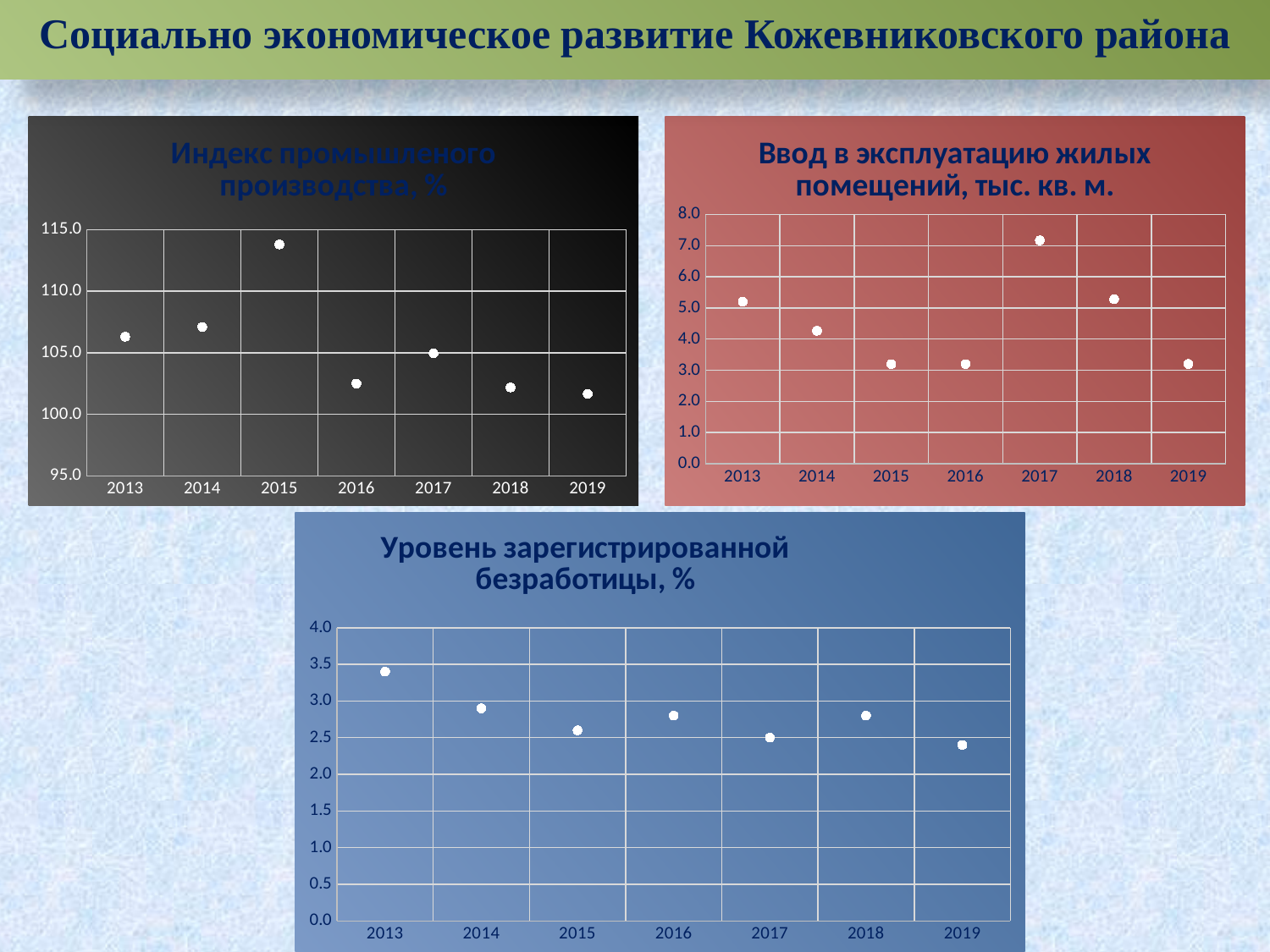
In the top-left chart, which year has the highest value? 2015 In the top-right chart 'Ввод в эксплуатацию жилых помещений, тыс. кв. м.', is the value for 2015 greater or less than 4.0? less In the bottom chart 'Уровень зарегистрированной безработицы, %', is the value for 2013 greater or less than 3.0? greater In the top-left chart, is the value for 2019 greater or less than 105.0? less How many years are plotted in the top-right chart 'Ввод в эксплуатацию жилых помещений, тыс. кв. м.'? 7 What type of chart is the bottom chart titled 'Уровень зарегистрированной безработицы, %'? scatter chart In the bottom chart 'Уровень зарегистрированной безработицы, %', which is larger, the value for 2013 or the value for 2019? 2013 In the top-right chart 'Ввод в эксплуатацию жилых помещений, тыс. кв. м.', which year has the highest value? 2017 In the bottom chart 'Уровень зарегистрированной безработицы, %', which year has the highest value? 2013